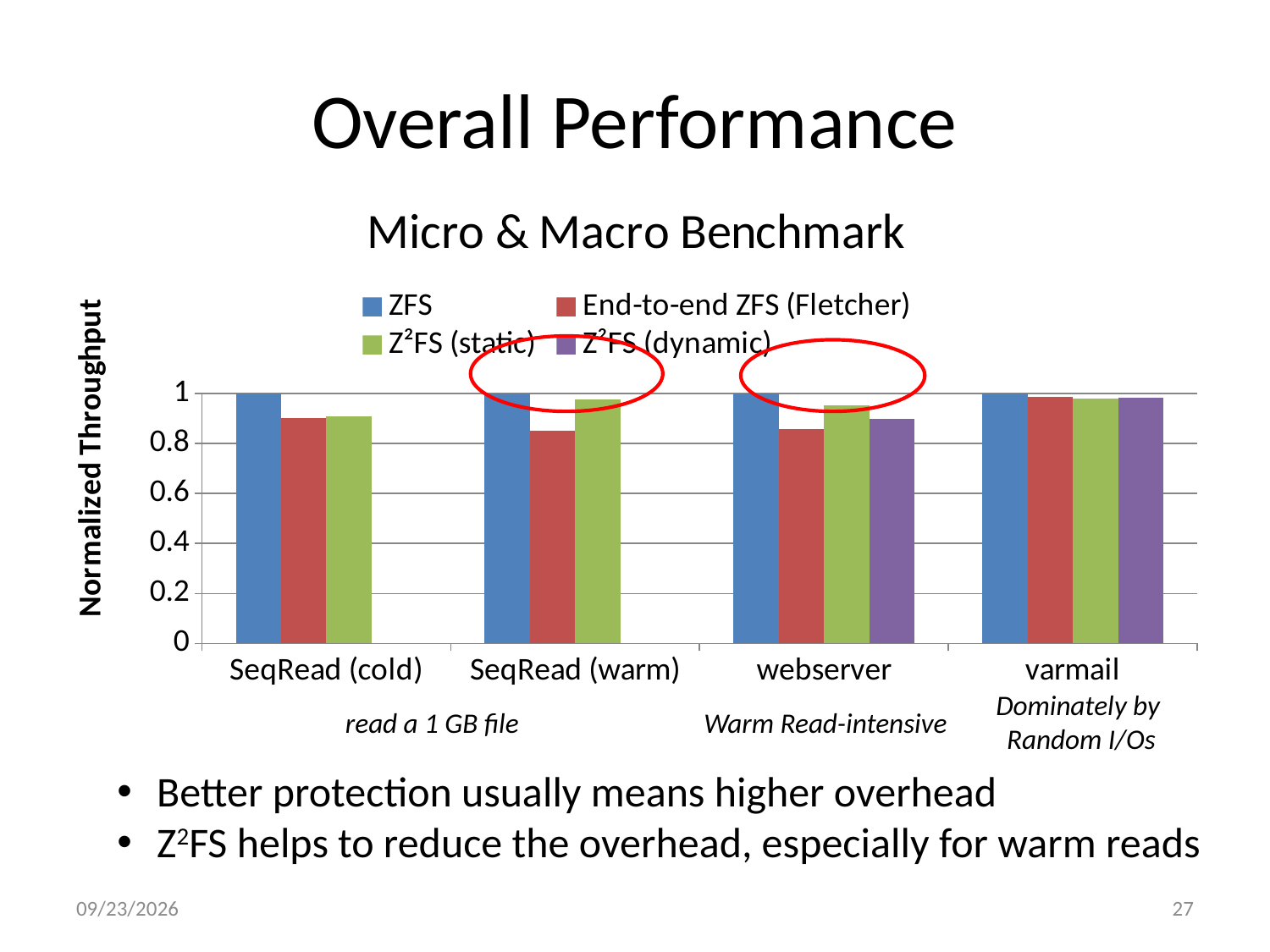
Is the value for Z²FS (dynamic) in the webserver benchmark greater or less than 0.8? greater What kind of chart is shown on the slide? bar chart What is the label of the y axis? Normalized Throughput In the SeqRead (warm) benchmark, which is larger: Z²FS (static) or End-to-end ZFS (Fletcher)? Z²FS (static) In the webserver benchmark, which series has the lowest normalized throughput? End-to-end ZFS (Fletcher) What is the title of the chart? Micro & Macro Benchmark What is the normalized throughput of ZFS for the webserver benchmark? 1 How many benchmark categories are shown on the x axis? 4 How many bars are plotted for the SeqRead (cold) benchmark? 3 Is the value for End-to-end ZFS (Fletcher) in the SeqRead (warm) benchmark greater or less than 0.8? greater Is the value for End-to-end ZFS (Fletcher) in the SeqRead (cold) benchmark greater or less than 1? less How many series does the chart legend list? 4